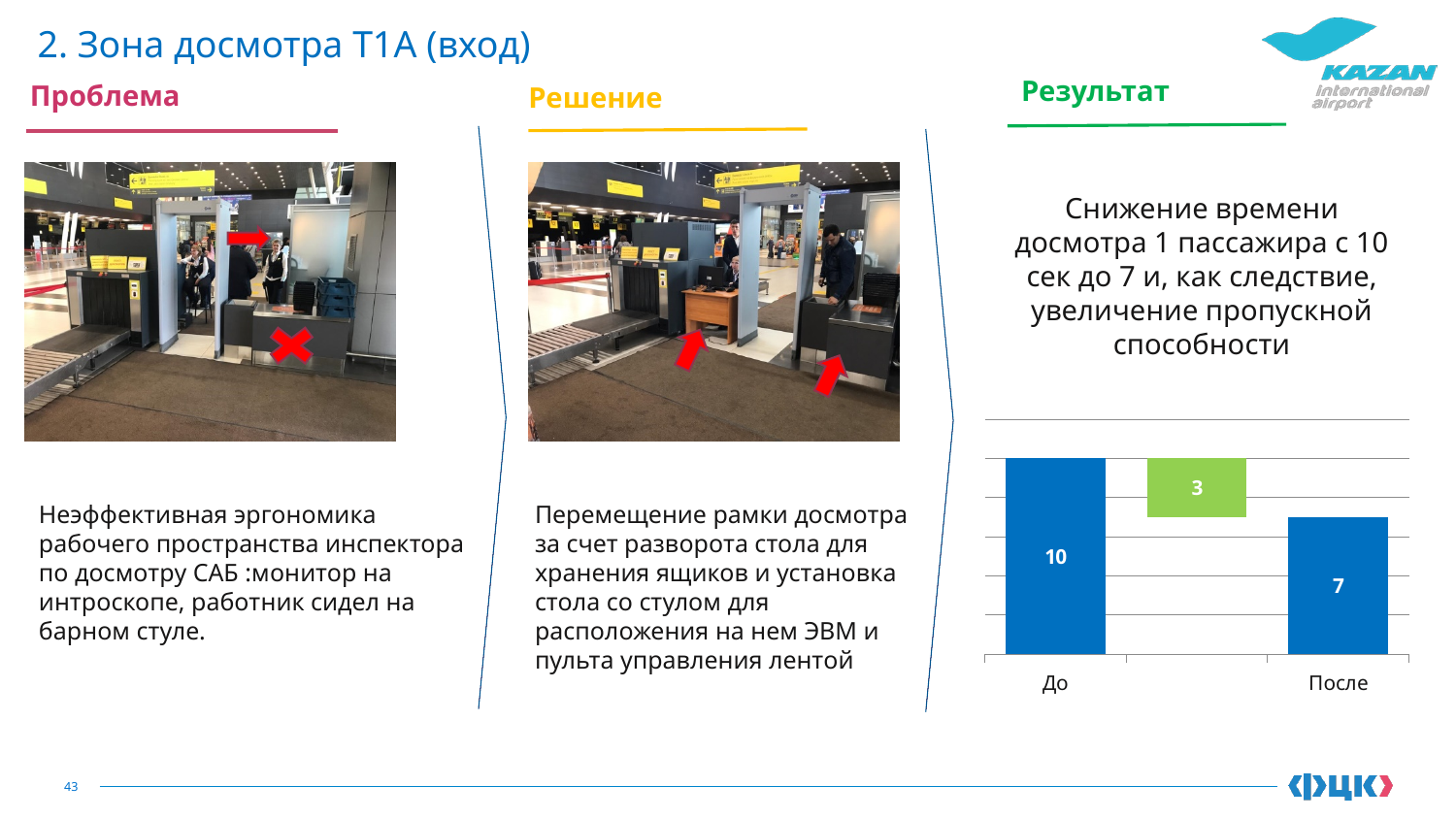
What is the value for "До" in the chart? 10 What is the difference between the values for "До" and "После"? 3 What is the value for "После" in the chart? 7 Which category has the lowest value in the chart? После Do the values fall or rise from "До" to "После"? Fall What colour is the bar labelled 3 in the chart? Green Which category has the highest value in the chart? До How many categories are labelled on the x axis of the chart? 2 Which category has the higher value, "До" or "После"? До What colour are the bars for "До" and "После"? Blue What value is printed on the green bar in the chart? 3 What kind of chart is shown on the slide? Bar chart